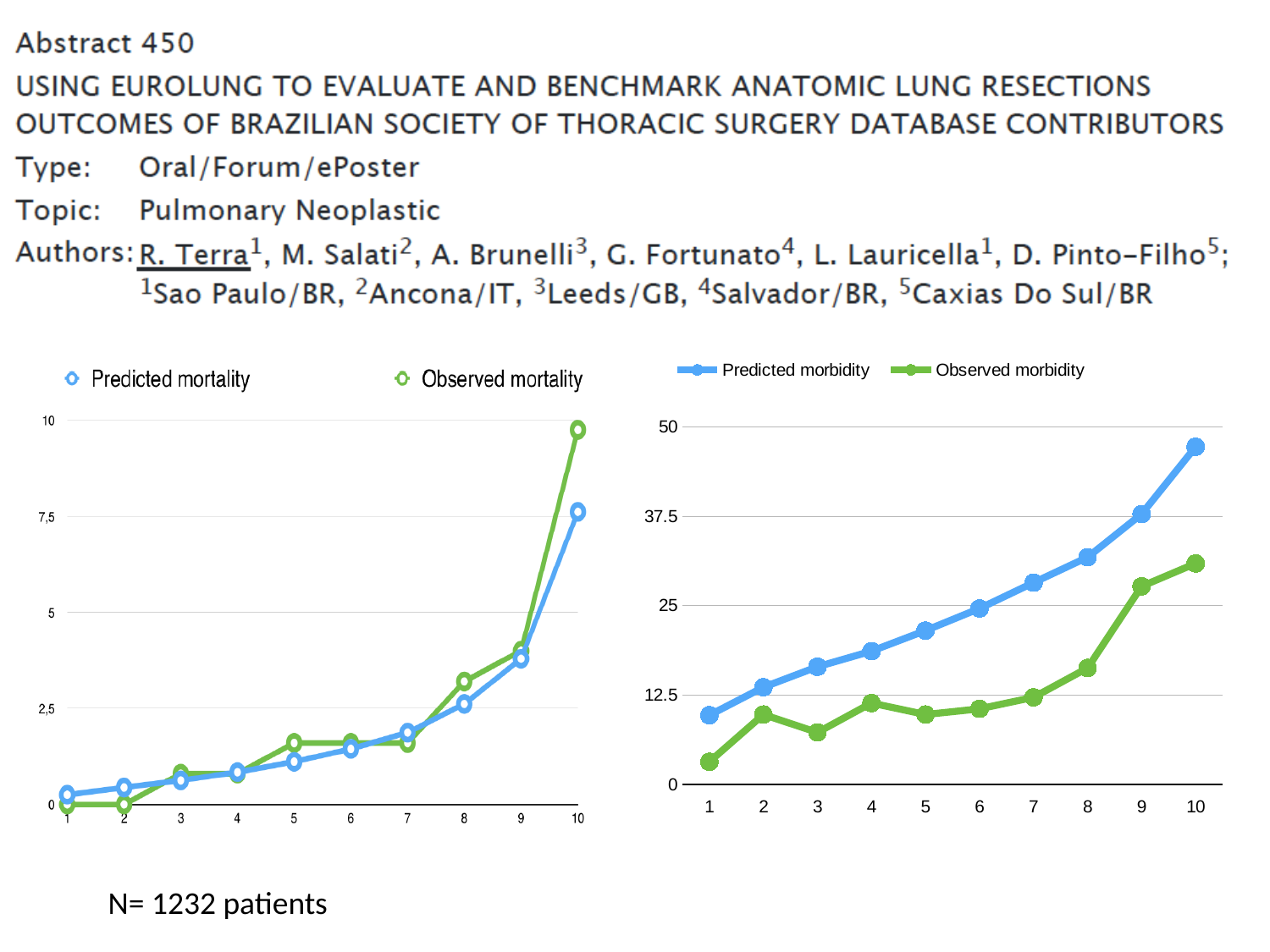
In the right chart (morbidity), how many series does the legend list? 2 In the right chart (morbidity), is the Observed morbidity value at x = 3 greater or less than 12.5? less In the right chart (morbidity), at x = 10, which is larger: Predicted morbidity or Observed morbidity? Predicted morbidity What are the two legend entries of the left chart? Predicted mortality and Observed mortality In the left chart (mortality), at x = 10, which is larger: Predicted mortality or Observed mortality? Observed mortality In the right chart (morbidity), is the Predicted morbidity value at x = 10 greater or less than 37.5? greater In the right chart (morbidity), at which x value is Observed morbidity highest? 10 In the right chart (morbidity), does the Predicted morbidity line rise or fall from 1 to 10 along the x axis? rise In the right chart (morbidity), is the Observed morbidity value at x = 10 greater or less than 25? greater In the left chart (mortality), how many points are plotted along the x axis for each series? 10 What kind of chart is the left chart showing predicted and observed mortality? line chart